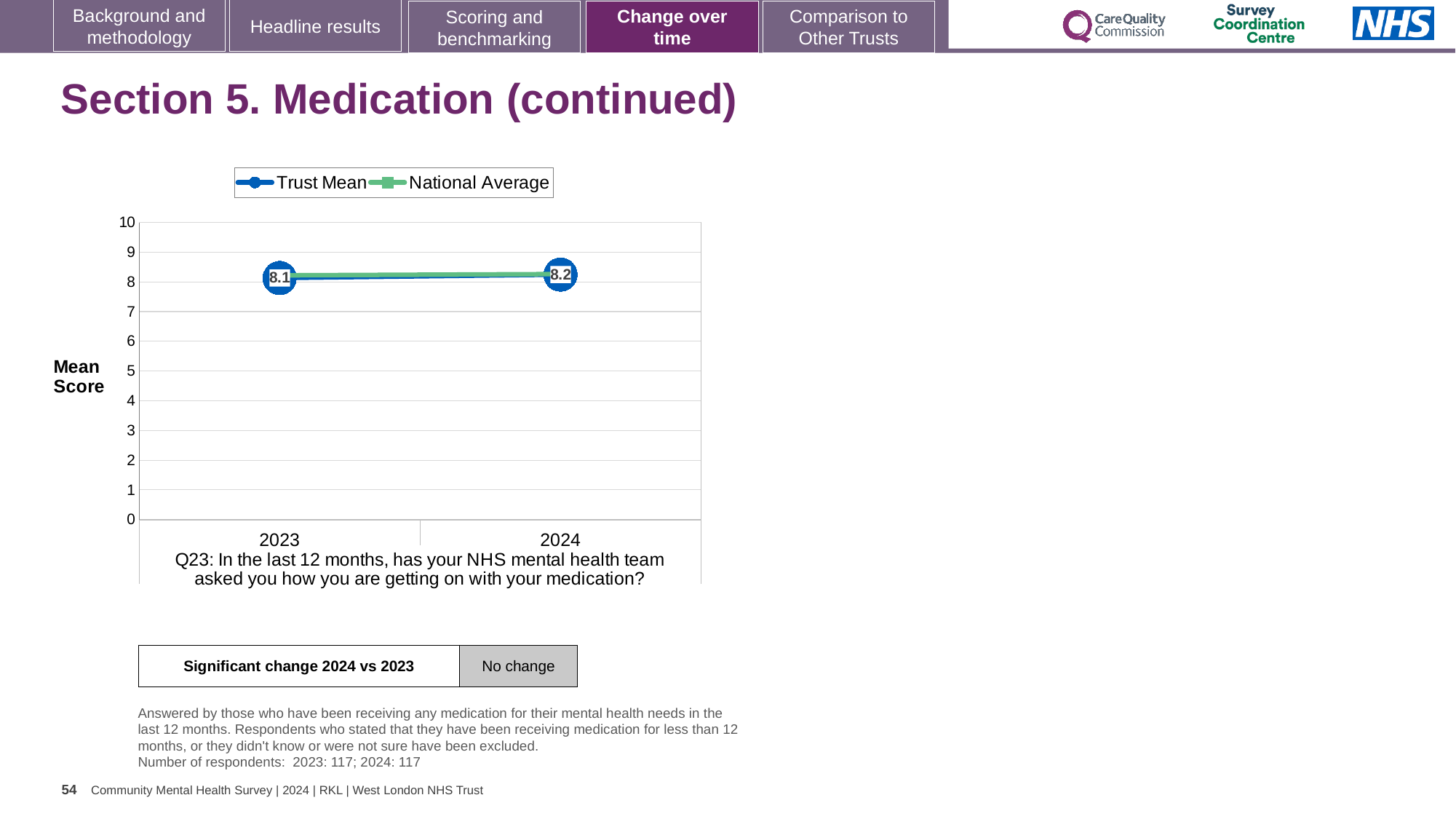
Is the National Average value for 2023 greater or less than 5? greater What is the Trust Mean value for 2024? 8.2 How many years are plotted on the x axis? 2 What kind of chart is shown on the slide? line chart How many series does the legend list? 2 What is the Trust Mean value for 2023? 8.1 By how much did the Trust Mean change from 2023 to 2024? 0.1 Is the National Average value for 2024 greater or less than 9? less Does the Trust Mean rise or fall from 2023 to 2024? rise In which year is the Trust Mean higher, 2023 or 2024? 2024 What is the label on the y axis of the chart? Mean Score What are the two series named in the legend? Trust Mean and National Average